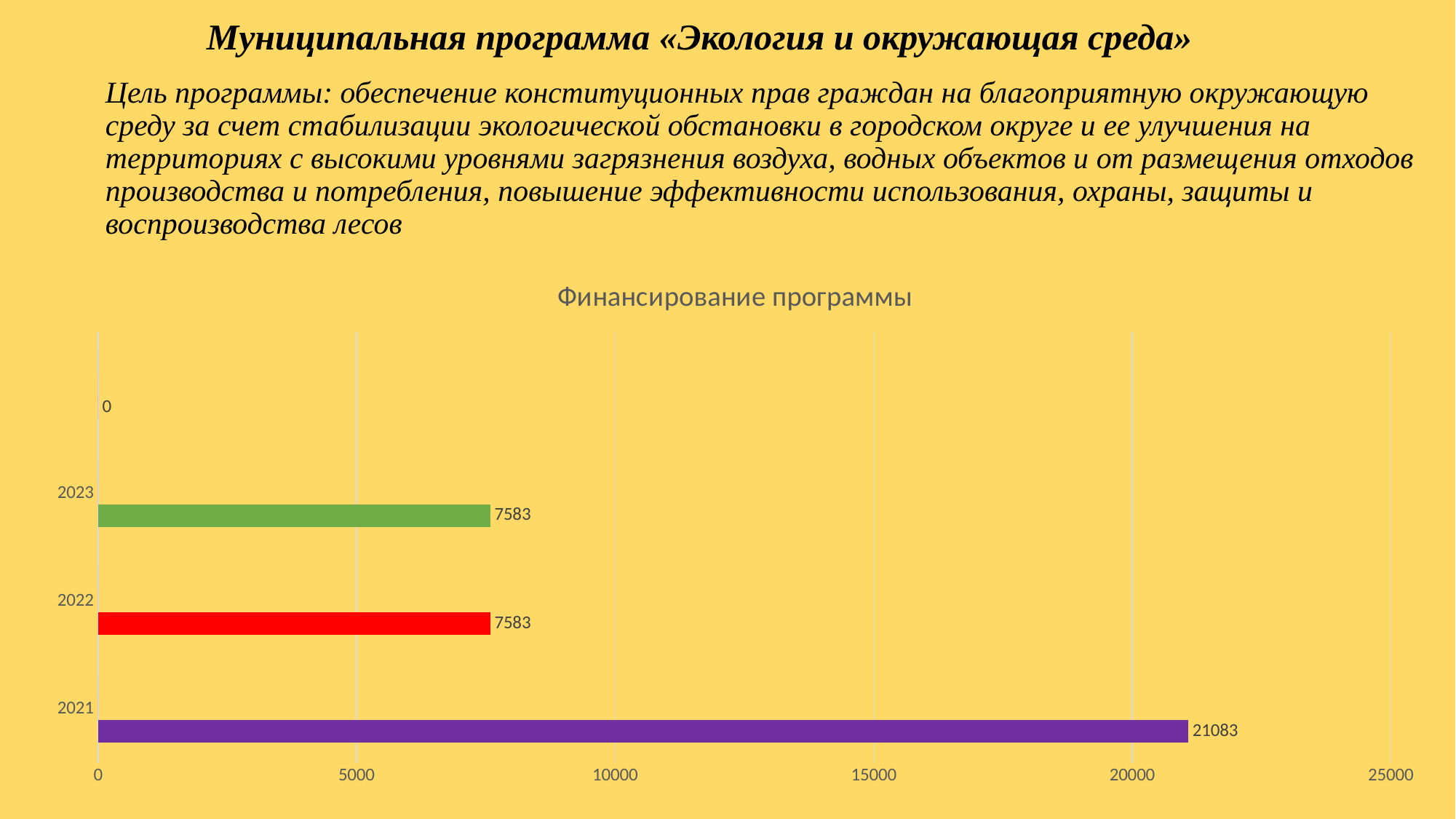
Does the value fall or rise from 2021 to 2022? fall Which year has the highest value in the chart? 2021 What is the difference between the values for 2021 and 2022? 13500 Is the value for 2022 greater or less than 10000? less Which is larger, the value for 2021 or the value for 2023? 2021 What kind of chart is shown on the slide? bar chart What is the title of the chart? Финансирование программы How many years are labeled on the vertical axis of the chart? 3 What is the value for 2022 in the chart? 7583 Is the value for 2021 greater or less than 20000? greater What is the value for 2021 in the chart? 21083 What is the value for 2023 in the chart? 7583